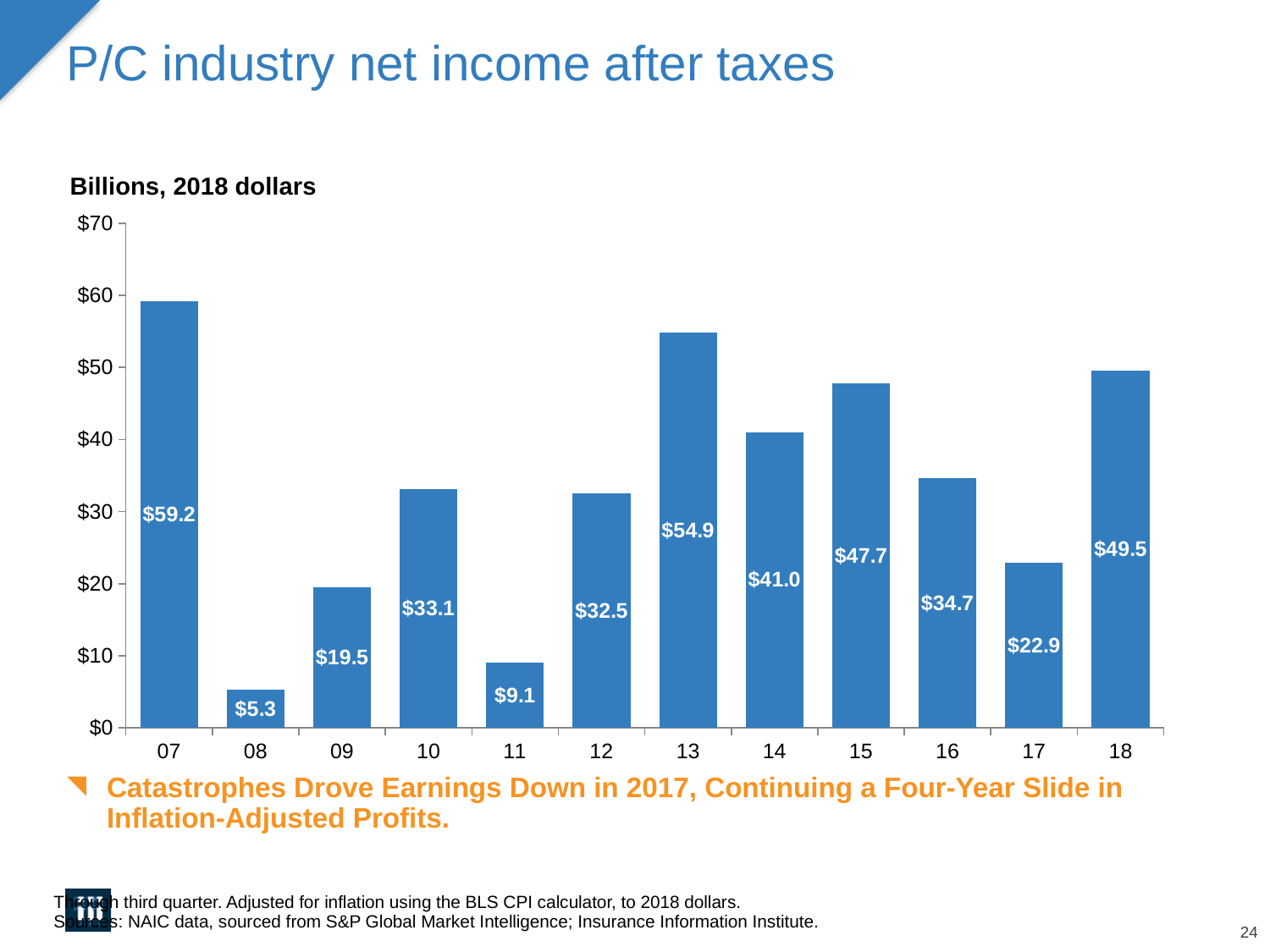
What is the difference between the values for 2007 and 2008? $53.9 Which year has the highest net income after taxes? 07 What is the difference between the values for 2016 and 2017? $11.8 Which year has the lowest net income after taxes? 08 What is the value shown for 2011? $9.1 What kind of chart is shown on the slide? bar chart What is the value shown for 2018? $49.5 Which is larger, the value for 2010 or the value for 2012? 2010 Is the value for 2014 greater or less than $40? greater How many years are shown on the x axis? 12 What is the P/C industry net income after taxes for 2013? $54.9